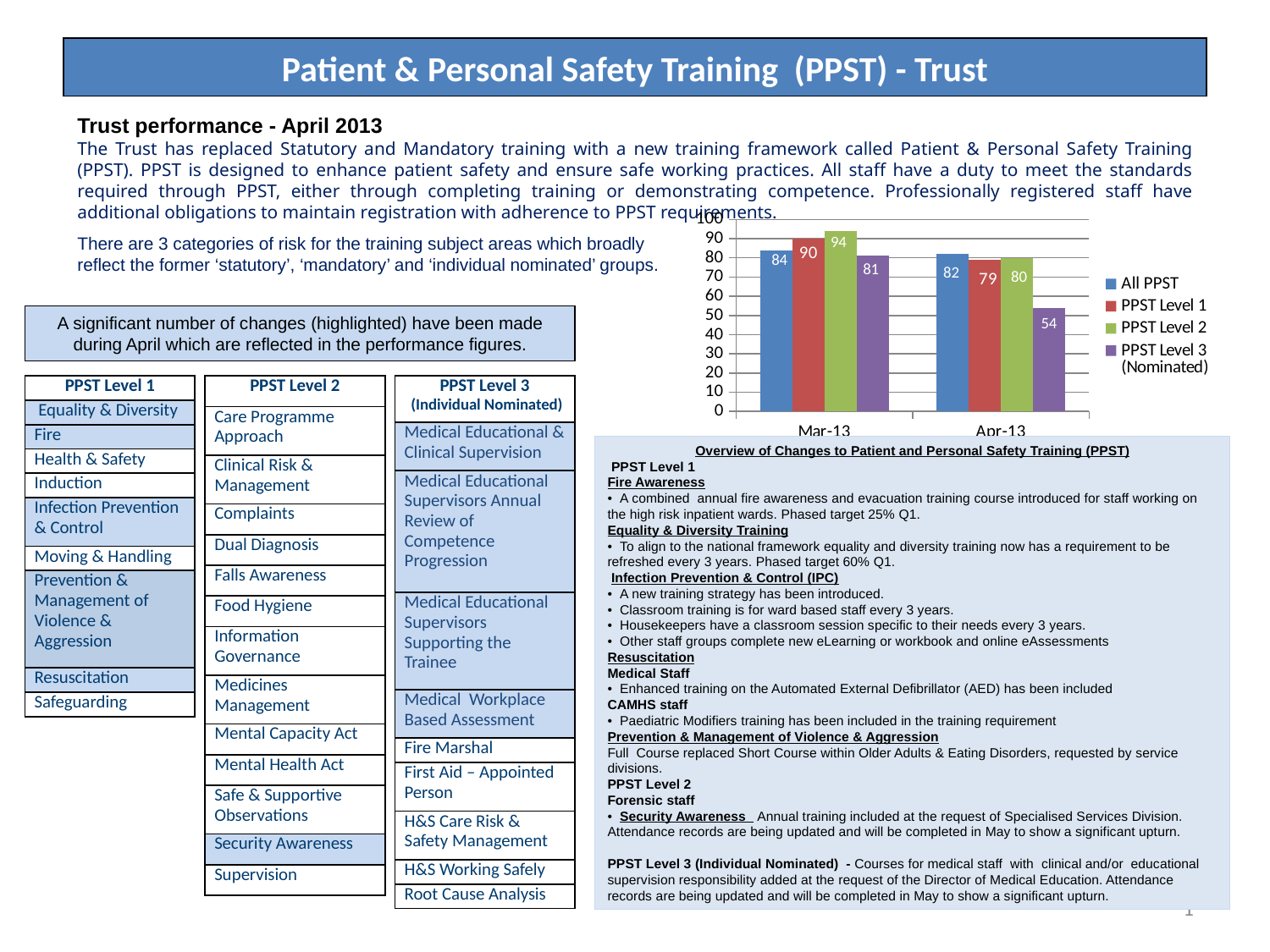
How many series does the chart legend list? 4 What is the value for All PPST in Mar-13? 84 What is the value for PPST Level 1 in Apr-13? 79 Does the All PPST value rise or fall from Mar-13 to Apr-13? fall Which series has the lowest value in Apr-13? PPST Level 3 (Nominated) Which series has the highest value in Mar-13? PPST Level 2 What is the difference between the PPST Level 3 (Nominated) values for Mar-13 and Apr-13? 27 What is the value for PPST Level 3 (Nominated) in Apr-13? 54 What is the value for PPST Level 2 in Mar-13? 94 What type of chart is shown on the slide? bar chart Is the value for PPST Level 1 larger in Mar-13 or Apr-13? Mar-13 How many categories are shown on the x axis of the chart? 2